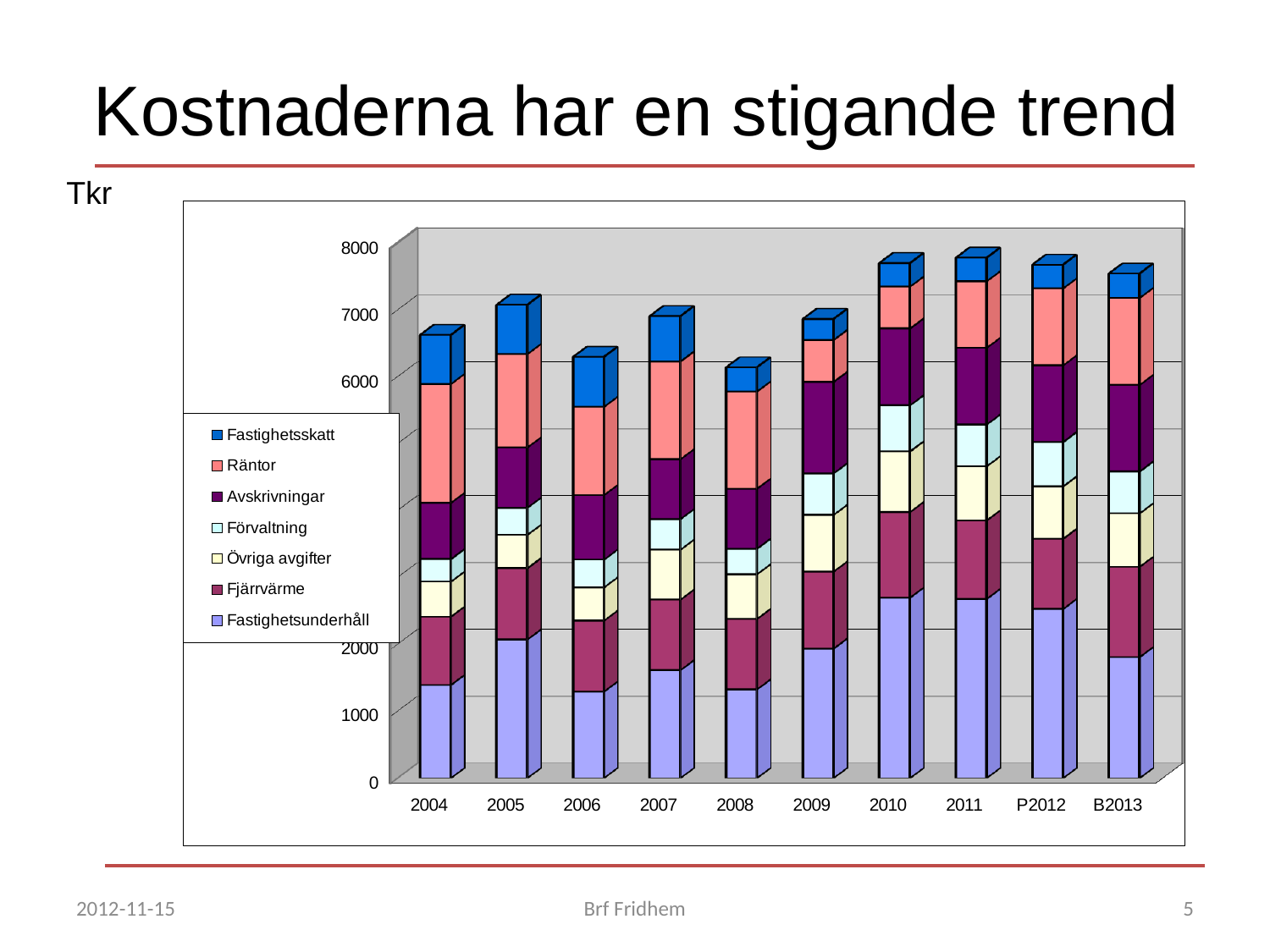
Is the Fastighetsunderhåll value for 2004 greater or less than 2000? less Is the total value of the bar for 2004 greater or less than 6000? greater How many series does the chart's legend list? 7 Is the Fastighetsunderhåll value for 2010 greater or less than 2000? greater Which series is listed first in the chart's legend? Fastighetsskatt Which bar has the larger total, 2008 or 2011? 2011 Do the total costs generally rise or fall from 2004 to B2013? Rise How many categories (years) are shown on the x axis of the chart? 10 Which bar has the larger total, 2004 or 2005? 2005 What kind of chart is shown on the slide? Stacked bar chart